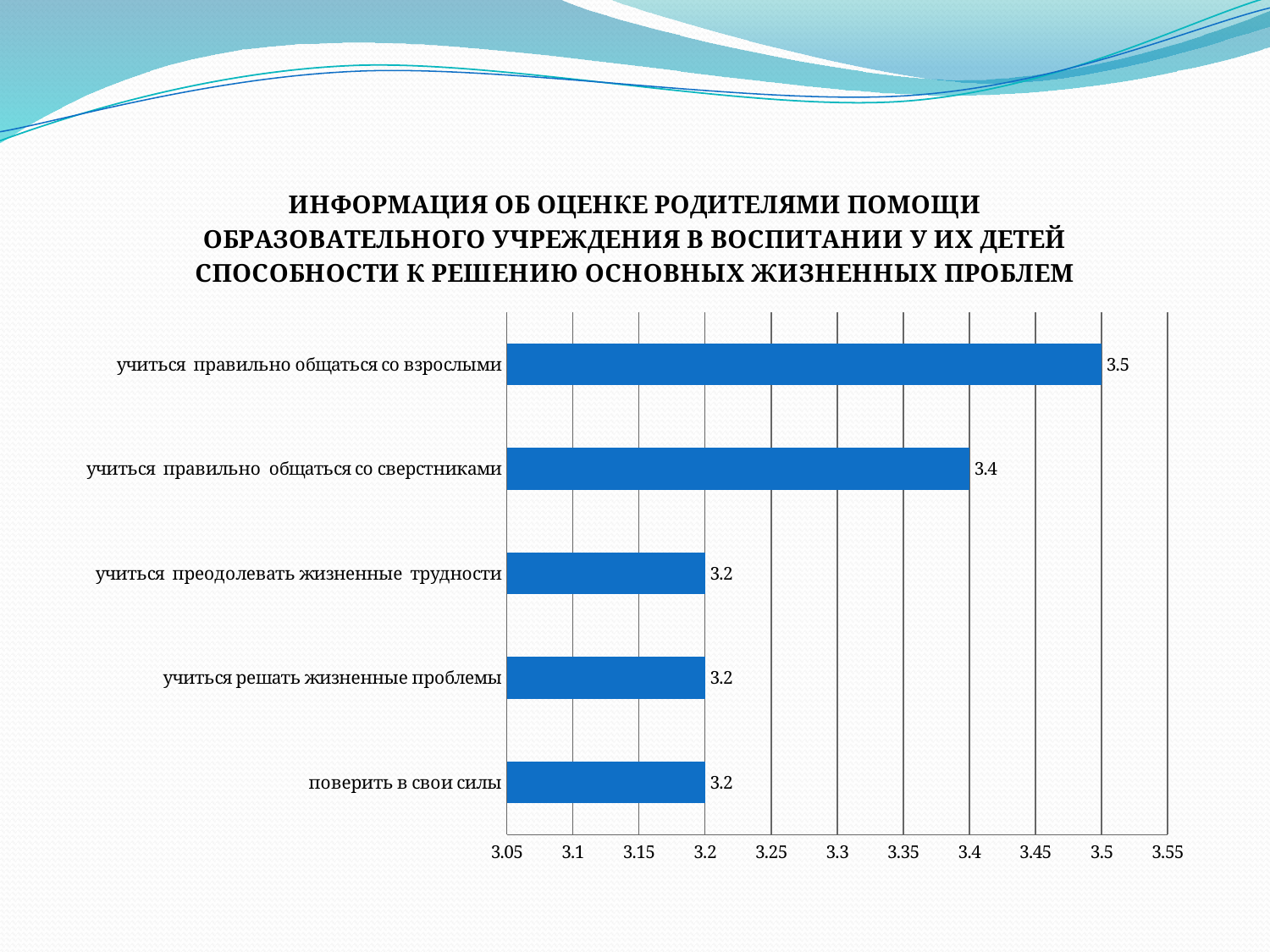
Which is larger, the value for "учиться правильно общаться со сверстниками" or the value for "поверить в свои силы"? учиться правильно общаться со сверстниками Which category has the highest value? учиться правильно общаться со взрослыми Is the value for "учиться правильно общаться со взрослыми" greater or less than 3.3? greater What is the difference between the values for "учиться правильно общаться со сверстниками" and "учиться решать жизненные проблемы"? 0.2 What kind of chart is shown on the slide? bar chart What is the value for "учиться преодолевать жизненные трудности"? 3.2 What is the value for "учиться правильно общаться со взрослыми"? 3.5 How many categories have a value of 3.2? 3 What is the value for "учиться правильно общаться со сверстниками"? 3.4 What is the difference between the values for "учиться правильно общаться со взрослыми" and "учиться правильно общаться со сверстниками"? 0.1 What is the value for "поверить в свои силы"? 3.2 How many categories are shown in the chart? 5